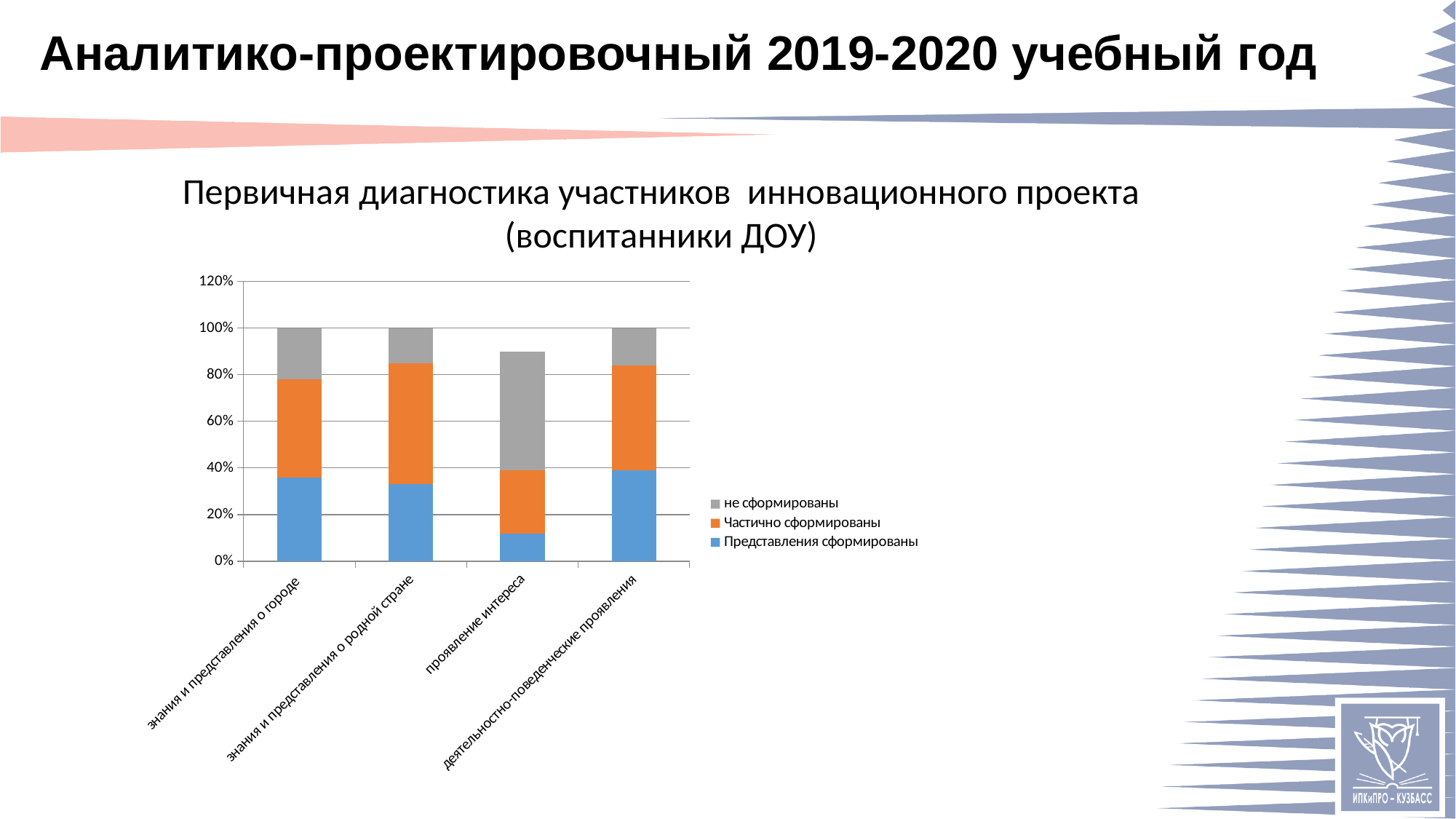
Which category has the largest "не сформированы" segment? проявление интереса What kind of chart is shown on the slide? Stacked bar chart How many categories are shown on the x axis of the chart? 4 Which series is shown in orange in the chart? Частично сформированы Is the value of "Представления сформированы" for "деятельностно-поведенческие проявления" greater or less than 20%? greater What is the total height of the stacked bar for "знания и представления о городе"? 100% What is the total height of the stacked bar for "деятельностно-поведенческие проявления"? 100% Is the value of "Представления сформированы" for "проявление интереса" greater or less than 20%? less Is the total height of the stacked bar for "проявление интереса" greater or less than 100%? less Which is larger: the "Представления сформированы" value for "знания и представления о городе" or for "проявление интереса"? знания и представления о городе Which category has the smallest "Представления сформированы" segment? проявление интереса How many series does the chart legend list? 3